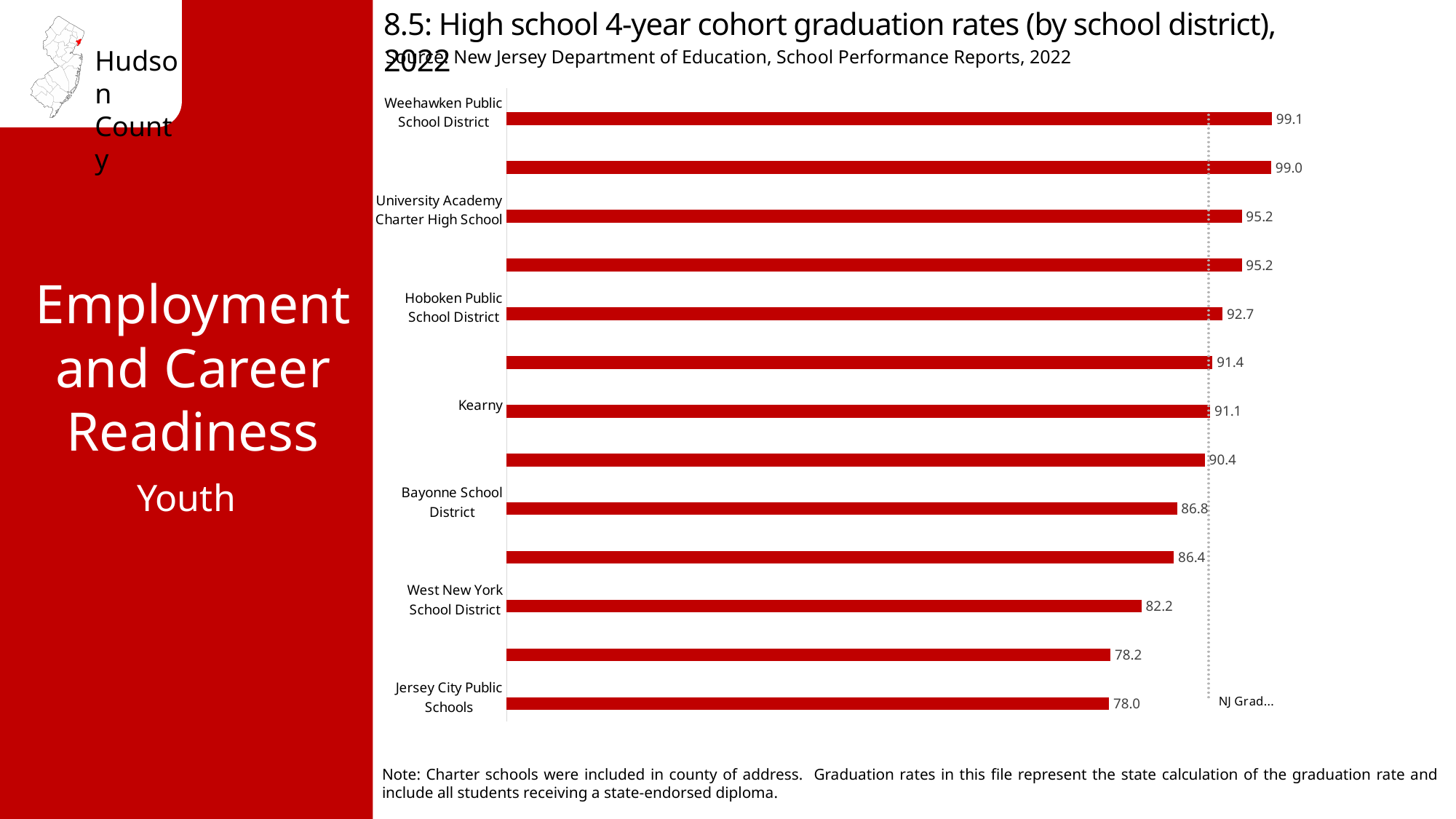
What is the graduation rate for Jersey City Public Schools? 78.0 What is the graduation rate for West New York School District? 82.2 What is the difference between the graduation rates of Weehawken Public School District and Jersey City Public Schools? 21.1 What is the graduation rate for University Academy Charter High School? 95.2 What is the graduation rate for Weehawken Public School District? 99.1 Which labeled district has the lowest graduation rate? Jersey City Public Schools What is the graduation rate for Kearny? 91.1 Which has a higher graduation rate, Bayonne School District or West New York School District? Bayonne School District What kind of chart is shown on the slide? Bar chart What is the graduation rate for Bayonne School District? 86.8 What is the graduation rate for Hoboken Public School District? 92.7 How many bars are plotted in the chart? 13